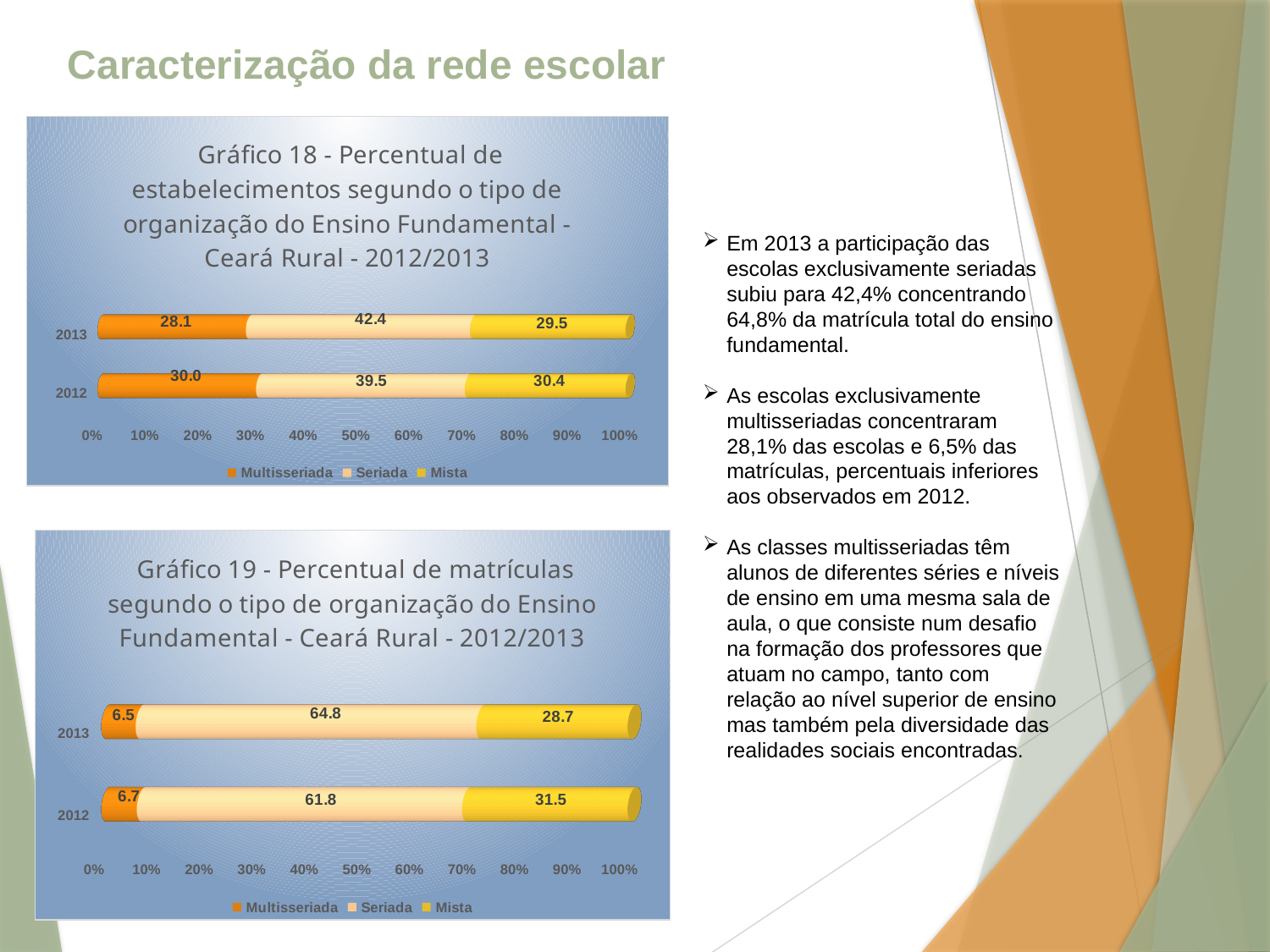
In Gráfico 19, what is the value for Mista in 2013? 28.7 In Gráfico 19, what is the value for Seriada in 2012? 61.8 In Gráfico 19, what is the difference between the Multisseriada values for 2012 and 2013? 0.2 In Gráfico 18, what is the difference between the Seriada values for 2013 and 2012? 2.9 How many series does the legend of Gráfico 19 list? 3 In Gráfico 19, which is larger: Mista in 2012 or Mista in 2013? Mista in 2012 What type of chart is Gráfico 19? Stacked bar chart In Gráfico 18, what is the value for Multisseriada in 2012? 30.0 How many years (categories) are shown in Gráfico 18? 2 In Gráfico 18, which series has the largest value in 2013? Seriada In Gráfico 19, which series has the smallest value in 2012? Multisseriada In Gráfico 18, what is the value for Seriada in 2013? 42.4